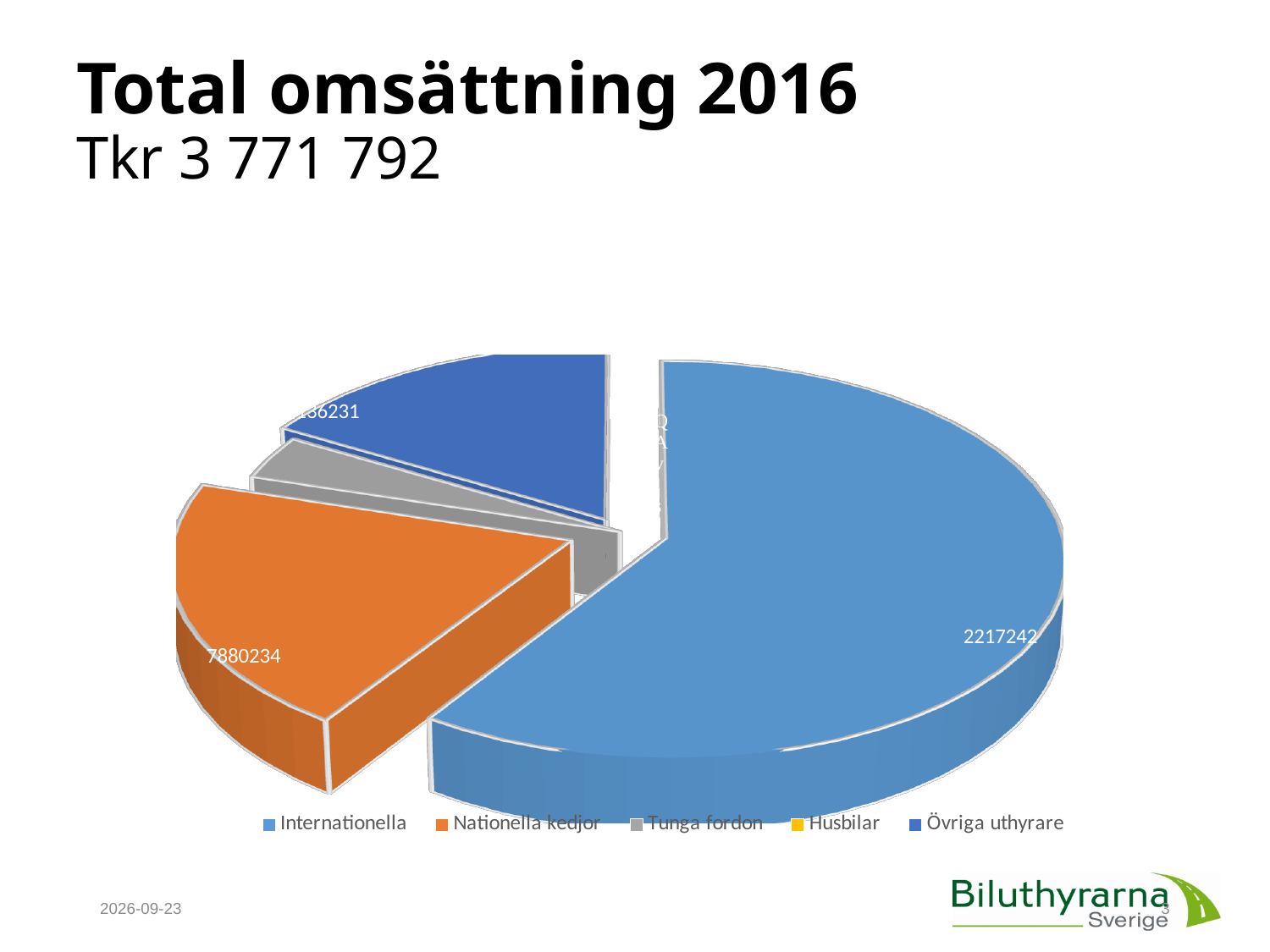
What is the title of the slide containing the pie chart? Total omsättning 2016 What kind of chart is shown on the slide? pie chart What colour is the Nationella kedjor slice in the pie chart? orange What value is shown on the Internationella slice? 2217242 How many categories does the legend of the pie chart list? 5 Which slice is larger, Internationella or Nationella kedjor? Internationella Which category has the largest slice in the pie chart? Internationella Which slice is larger, Nationella kedjor or Tunga fordon? Nationella kedjor Which slice is larger, Övriga uthyrare or Tunga fordon? Övriga uthyrare